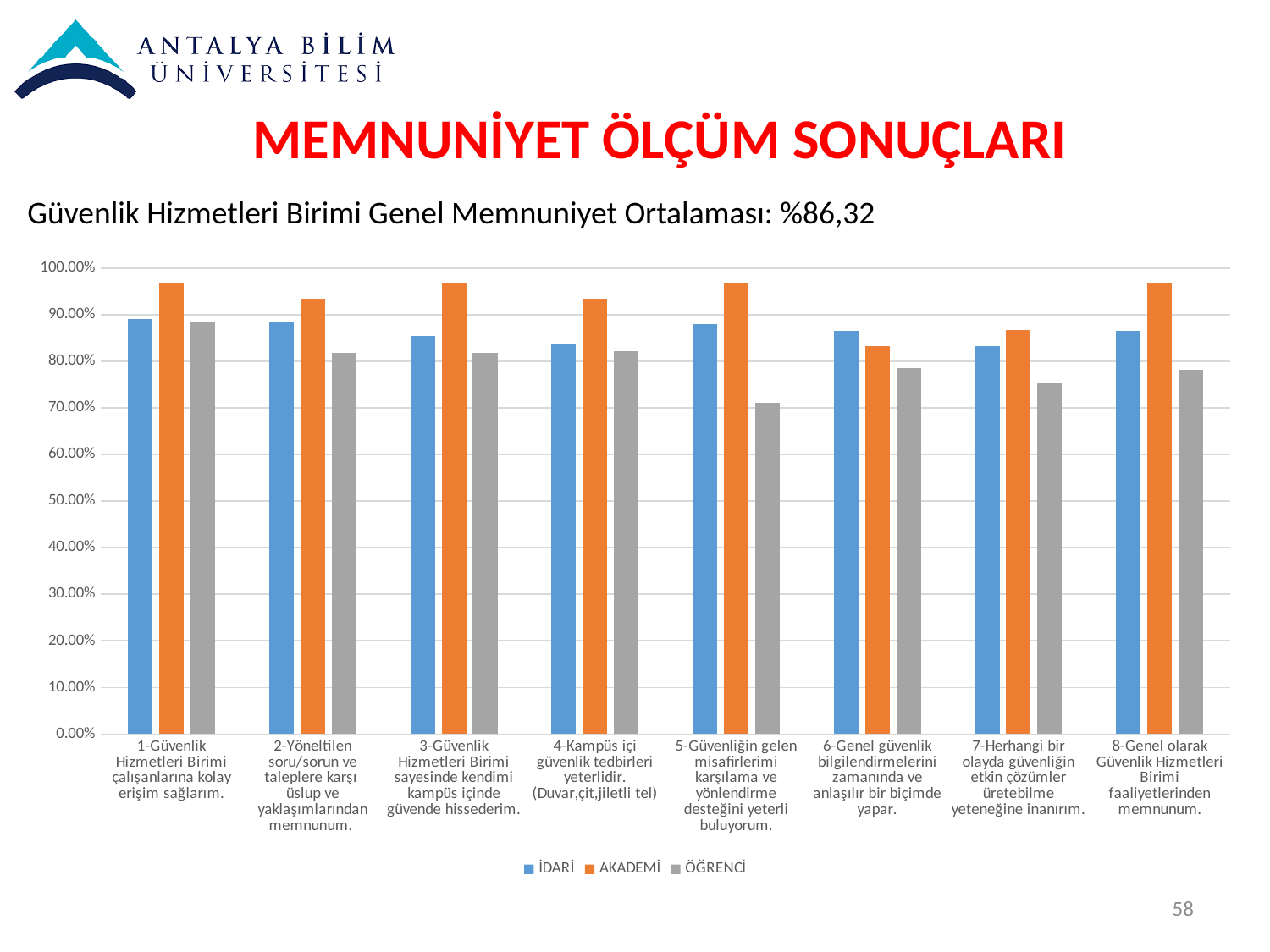
Is the İDARİ value for category 1 (Güvenlik Hizmetleri Birimi çalışanlarına kolay erişim sağlarım.) greater or less than 80.00%? greater Which series is shown in orange in the legend? AKADEMİ How many series does the legend list? 3 Among the ÖĞRENCİ bars, which category has the lowest value? 5-Güvenliğin gelen misafirlerimi karşılama ve yönlendirme desteğini yeterli buluyorum. Is the ÖĞRENCİ value for category 5 (Güvenliğin gelen misafirlerimi karşılama ve yönlendirme desteğini yeterli buluyorum.) greater or less than 80.00%? less Is the ÖĞRENCİ value for category 7 (Herhangi bir olayda güvenliğin etkin çözümler üretebilme yeteneğine inanırım.) greater or less than 80.00%? less For category 5 (Güvenliğin gelen misafirlerimi karşılama ve yönlendirme desteğini yeterli buluyorum.), which is larger: the AKADEMİ value or the ÖĞRENCİ value? AKADEMİ Among the AKADEMİ bars, which category has the lowest value? 6-Genel güvenlik bilgilendirmelerini zamanında ve anlaşılır bir biçimde yapar. How many categories (questions) are shown along the x axis? 8 What kind of chart is shown on the slide? bar chart What overall satisfaction average is stated above the chart for Güvenlik Hizmetleri Birimi? %86,32